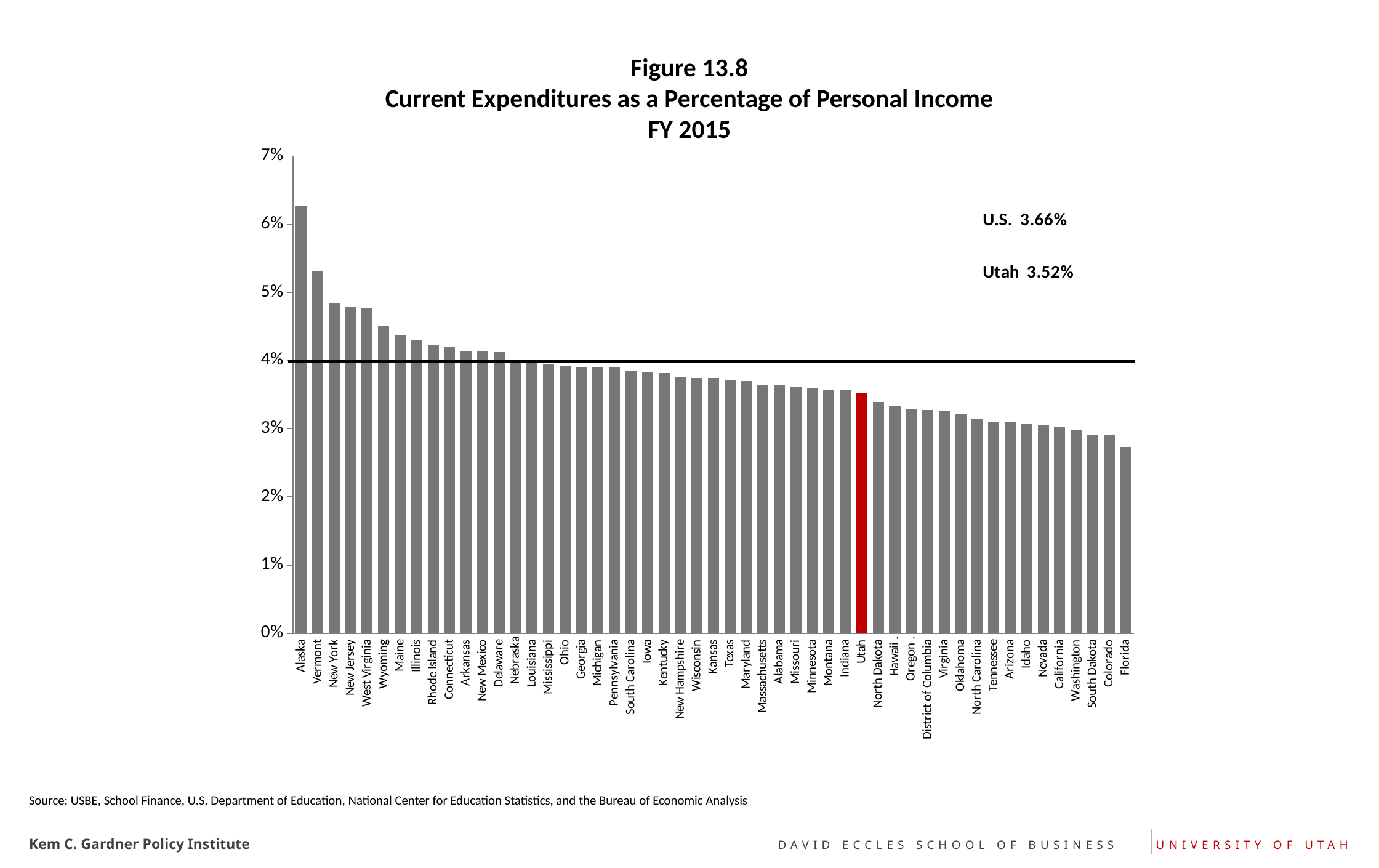
Is the value for Vermont greater or less than 5%? greater By how many percentage points does the U.S. value exceed the Utah value? 0.14 percentage points What is the value shown for Utah on the chart? 3.52% Which is larger, the value for Alaska or the value for Vermont? Alaska Which state has the highest current expenditures as a percentage of personal income? Alaska What is the U.S. value shown on the chart? 3.66% Which state has the lowest current expenditures as a percentage of personal income? Florida Is the value for Alaska greater or less than 6%? greater What colour is the bar for Utah? red Is the value for Florida greater or less than 3%? less Do the values rise or fall moving from left to right along the x axis? fall What kind of chart is shown on the slide? bar chart